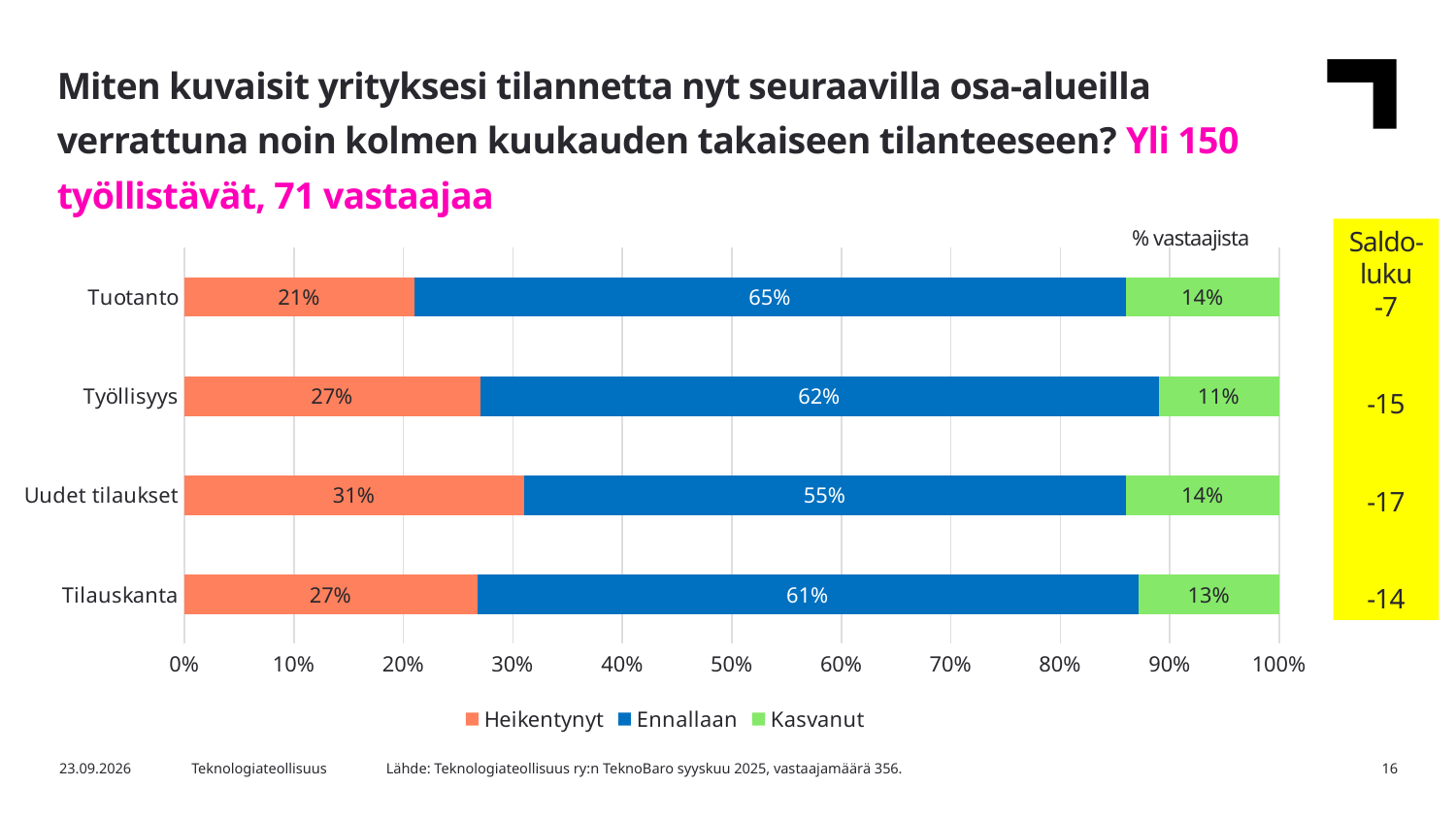
Which category has the highest Heikentynyt share? Uudet tilaukset What is the Heikentynyt value for Uudet tilaukset? 31% Which is larger, the Kasvanut value for Työllisyys or for Tuotanto? Tuotanto What is the Saldoluku value shown for Uudet tilaukset? -17 What percentage of respondents answered Ennallaan for Tuotanto? 65% What kind of chart is shown on the slide? Stacked bar chart Which category has the lowest Ennallaan share? Uudet tilaukset What is the Kasvanut value for Tilauskanta? 13% What is the total of the stacked bar for Työllisyys? 100% What is the difference between the Ennallaan values for Tuotanto and Tilauskanta? 4 percentage points How many series does the legend list? 3 How many categories are shown on the y axis of the chart? 4